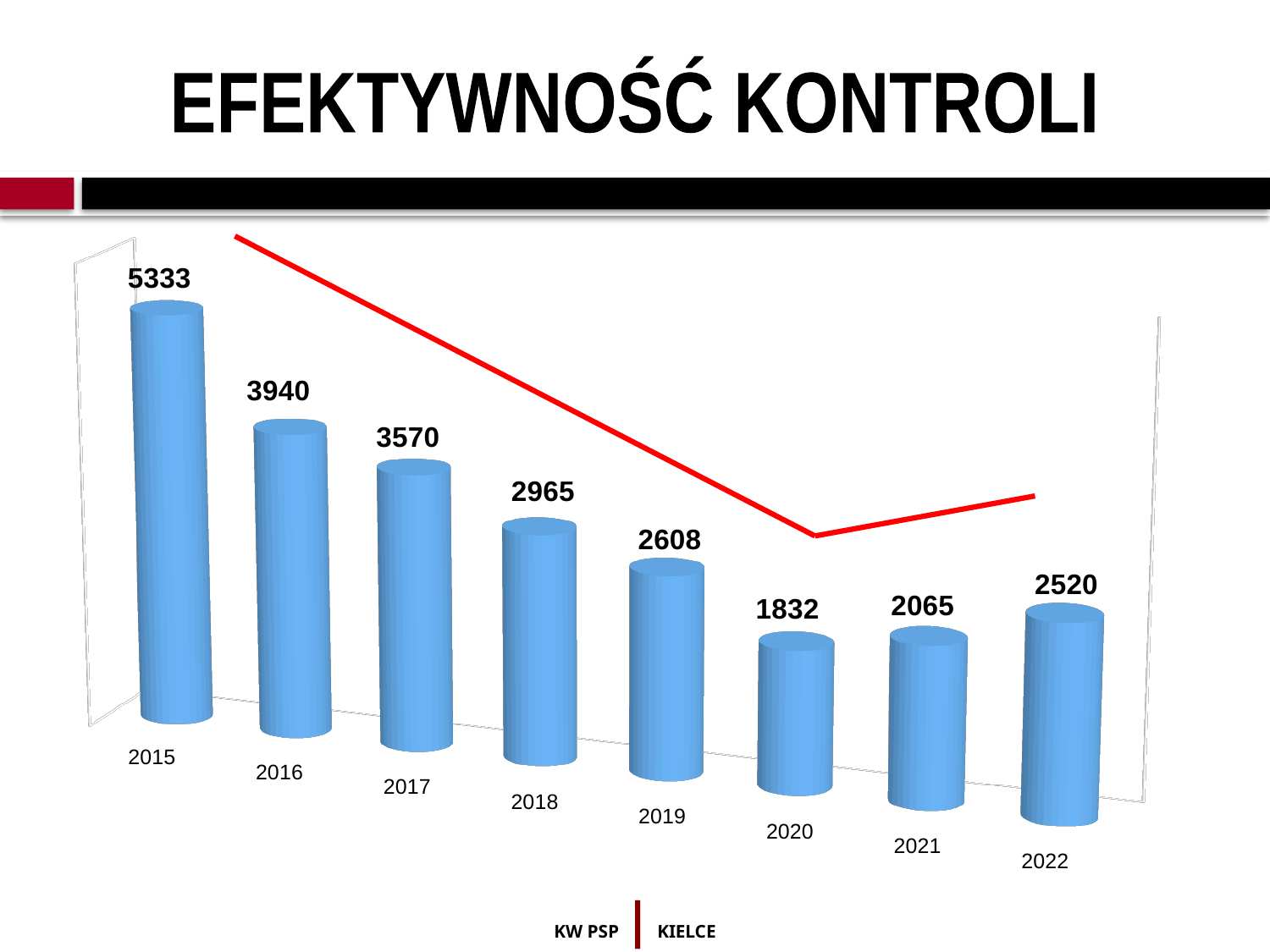
Which year has the lowest value? 2020 What is the title of the slide? EFEKTYWNOŚĆ KONTROLI Which year has the highest value? 2015 What is the difference between the values for 2015 and 2016? 1393 What is the value for 2022? 2520 What is the value for 2015? 5333 How many years are shown on the chart? 8 What kind of chart is shown on the slide? bar chart What is the difference between the values for 2022 and 2021? 455 Do the values rise or fall from 2015 to 2020? fall What is the value for 2020? 1832 Which is larger, the value for 2017 or the value for 2018? 2017